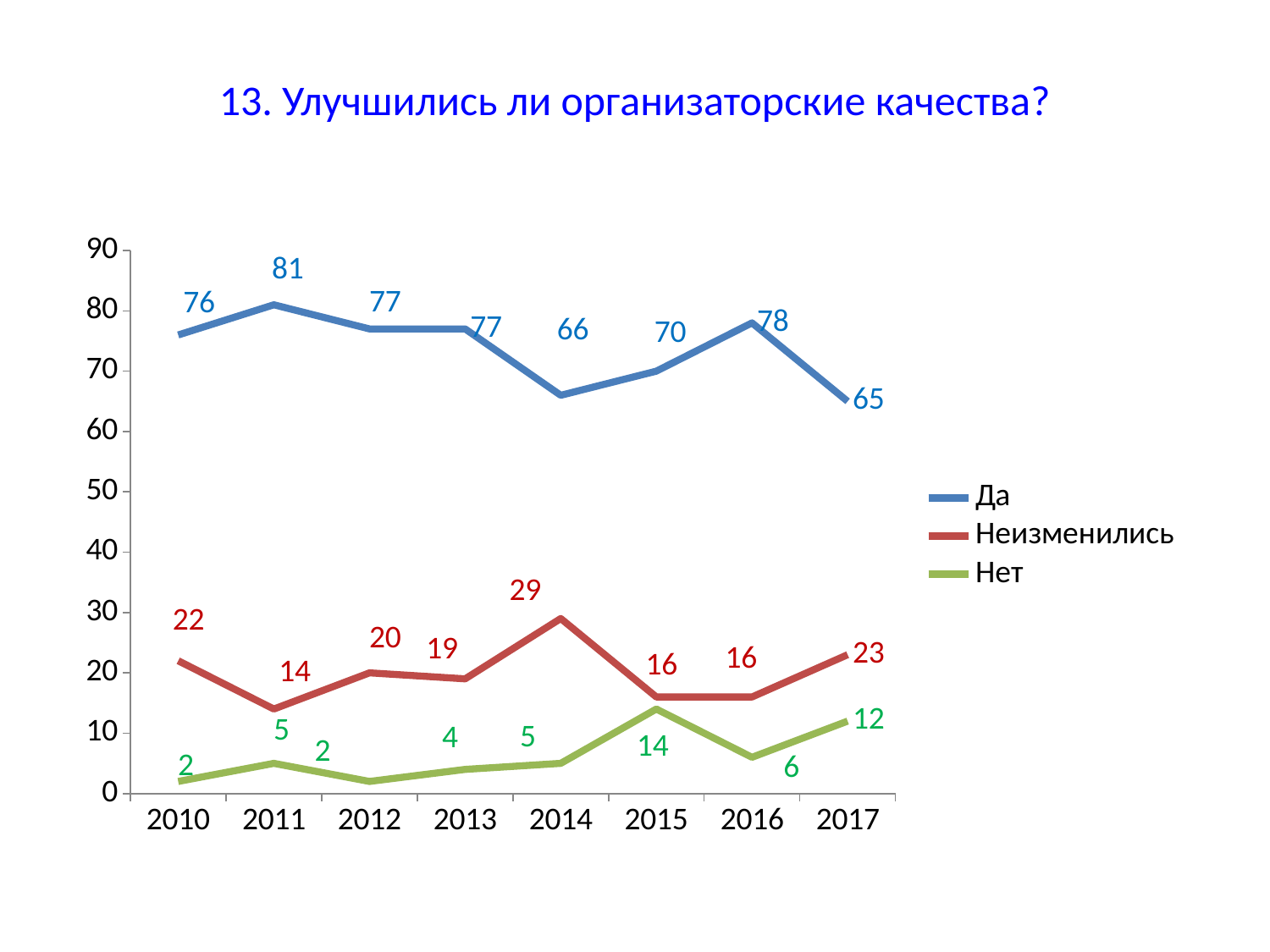
What value does the "Да" series have in 2011? 81 What kind of chart is shown on the slide? Line chart What is the title of the chart? 13. Улучшились ли организаторские качества? What is the difference between the "Да" values in 2016 and 2017? 13 In which year is the "Да" series at its lowest? 2017 What value does the "Неизменились" series have in 2014? 29 What value does the "Нет" series have in 2015? 14 How many years are shown on the x axis? 8 Which is larger: the "Нет" value in 2016 or in 2017? 2017 In which year is the "Неизменились" series at its highest? 2014 Does the "Да" series rise or fall from 2013 to 2014? Fall How many series does the legend list? 3